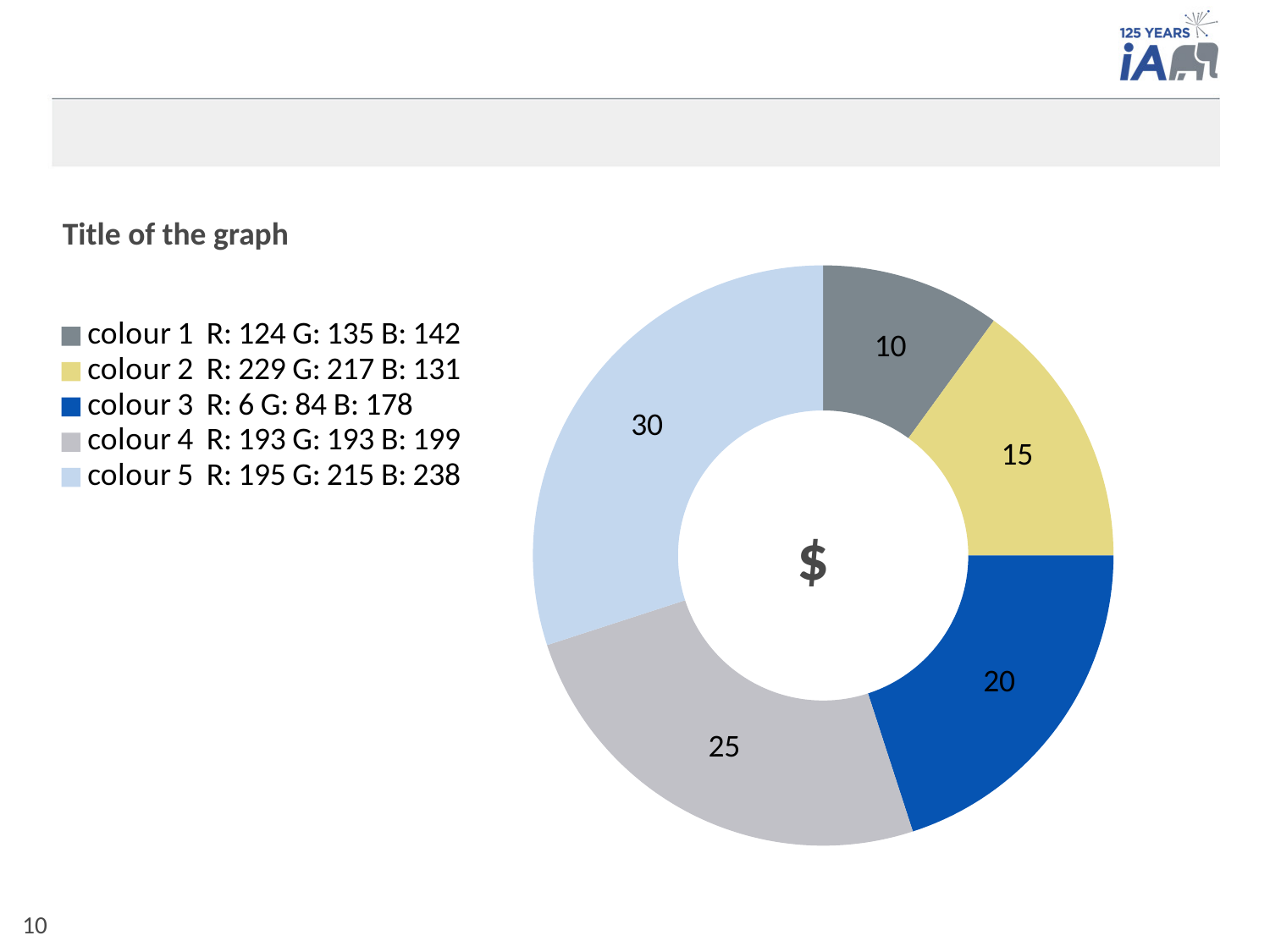
Which legend entry has the largest slice? colour 5 R: 195 G: 215 B: 238 Which legend entry has the smallest slice? colour 1 R: 124 G: 135 B: 142 What is the value of the slice for colour 1 (R: 124 G: 135 B: 142)? 10 Which is larger, the slice for colour 4 or the slice for colour 3? colour 4 What share of the total does the slice for colour 5 represent? 30% What is the value of the slice for colour 5 (R: 195 G: 215 B: 238)? 30 What is the value of the slice for colour 3 (R: 6 G: 84 B: 178)? 20 What is the title of the chart? Title of the graph How many slices does the doughnut chart have? 5 How many entries does the legend list? 5 What is the difference between the values for colour 5 and colour 2? 15 What kind of chart is shown on the slide? doughnut chart